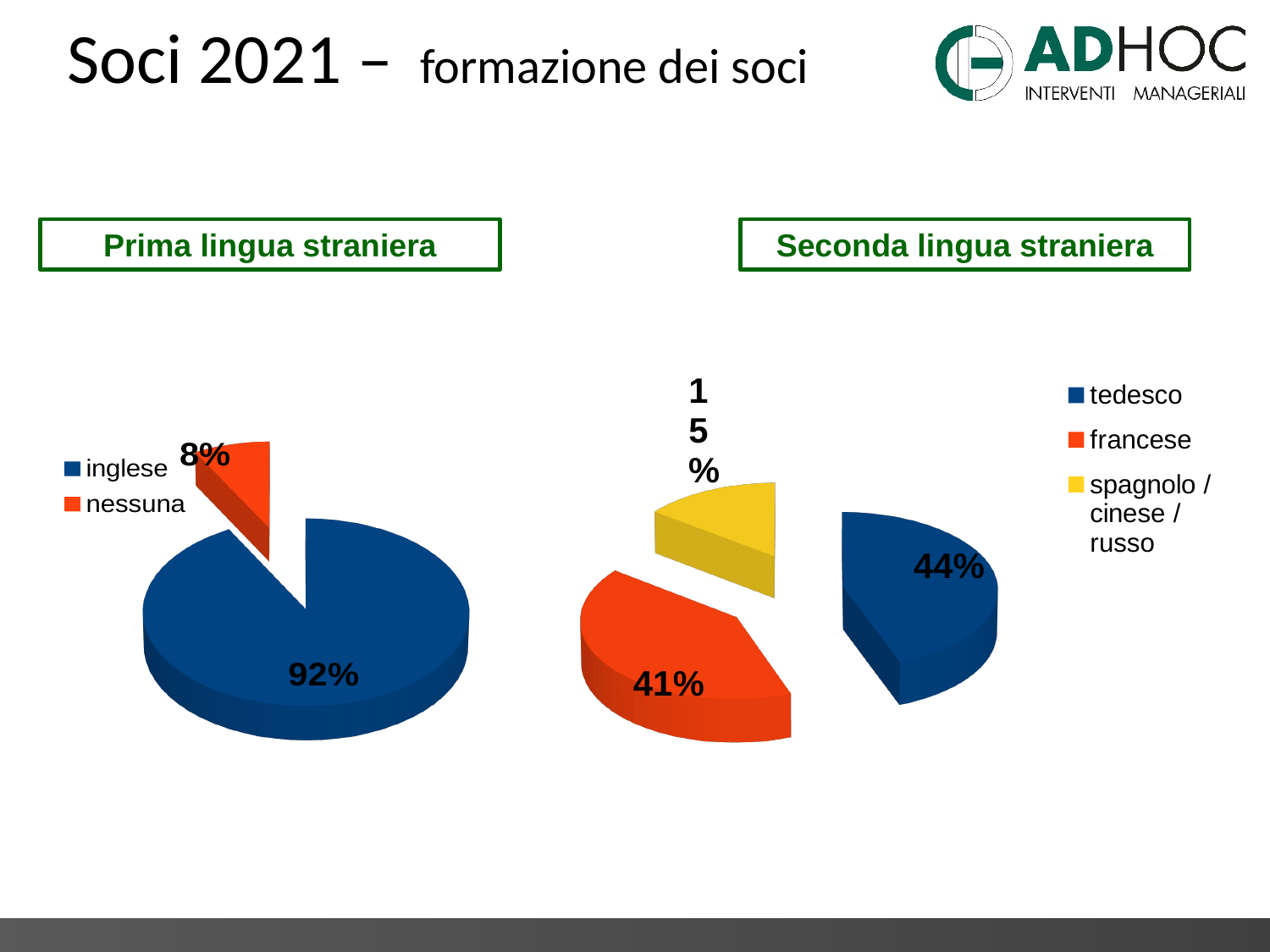
In the 'Prima lingua straniera' chart, what share is shown for inglese? 92% In the 'Prima lingua straniera' chart, what colour is the slice for nessuna? Orange-red In the 'Seconda lingua straniera' chart, what share is shown for francese? 41% In the 'Prima lingua straniera' chart, what is the difference in percentage points between inglese and nessuna? 84 In the 'Seconda lingua straniera' chart, what is the difference in percentage points between tedesco and spagnolo / cinese / russo? 29 In the 'Prima lingua straniera' chart, what share is shown for nessuna? 8% In the 'Seconda lingua straniera' chart, what share is shown for tedesco? 44% What type of chart is used for 'Prima lingua straniera'? Pie chart In the 'Seconda lingua straniera' chart, which category has the largest slice? tedesco In the 'Seconda lingua straniera' chart, which category has the smallest slice? spagnolo / cinese / russo In the 'Seconda lingua straniera' chart, what share is shown for spagnolo / cinese / russo? 15% In the 'Seconda lingua straniera' chart, how many categories does the legend list? 3